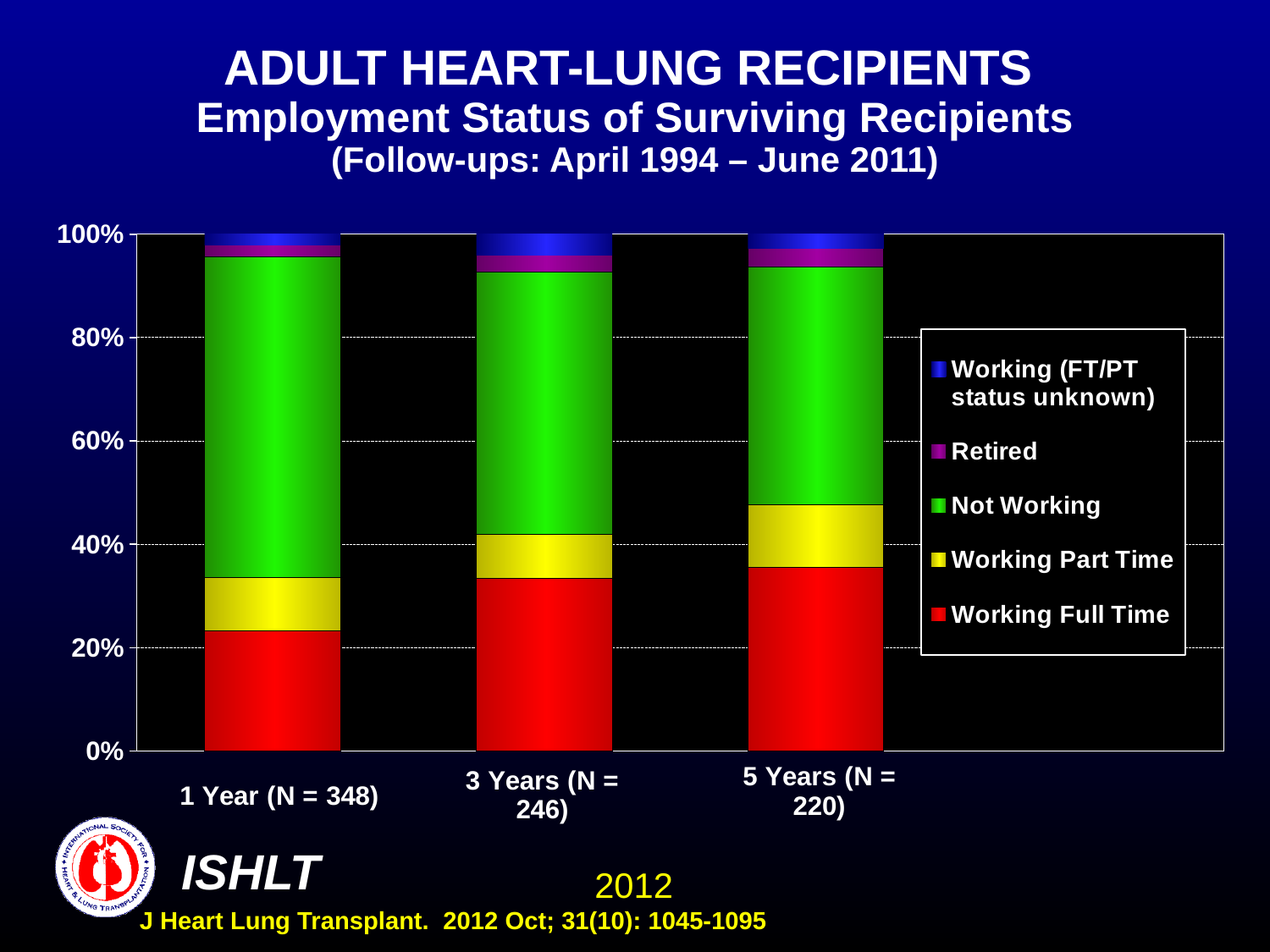
Which colour represents Retired in the legend? purple How many series does the legend list? 5 How many follow-up time points (categories) are shown on the x axis? 3 Which has the larger Working Full Time share, 1 Year or 5 Years? 5 Years Is the Working Full Time share at 5 Years greater or less than 20%? greater Is the Working Full Time share at 1 Year greater or less than 40%? less What is the N for the 1 Year category? 348 Which has the larger Not Working share, 1 Year or 5 Years? 1 Year Is the Not Working share at 1 Year greater or less than 40%? greater Does the Not Working share rise or fall from 1 Year to 5 Years? fall Does the Working Full Time share rise or fall from 1 Year to 5 Years? rise What kind of chart is shown on the slide? bar chart